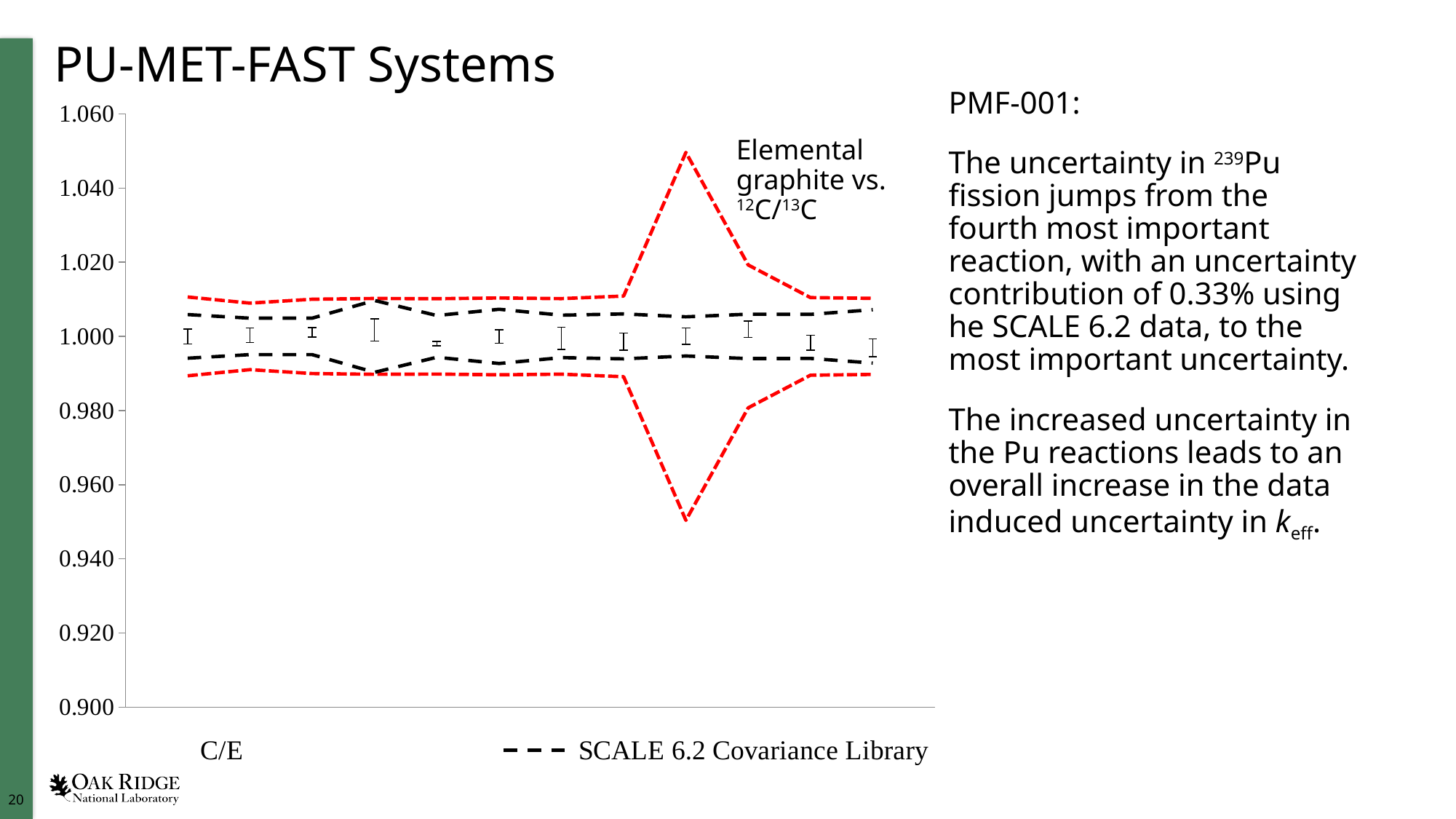
What is the legend label for the black dashed line? SCALE 6.2 Covariance Library Is the upper black dashed SCALE 6.2 Covariance Library line greater or less than 1.020 across the whole chart? less What kind of chart is shown on the slide? line chart What text annotation appears inside the plot area near the top right? Elemental graphite vs. 12C/13C Are all of the C/E points greater or less than 1.020? less Is the lower black dashed SCALE 6.2 Covariance Library line greater or less than 0.980 across the whole chart? greater How many C/E data points (error bars) are plotted on the chart? 12 What is the highest tick value shown on the y axis? 1.060 How many entries does the chart legend list? 2 What is the lowest tick value shown on the y axis? 0.900